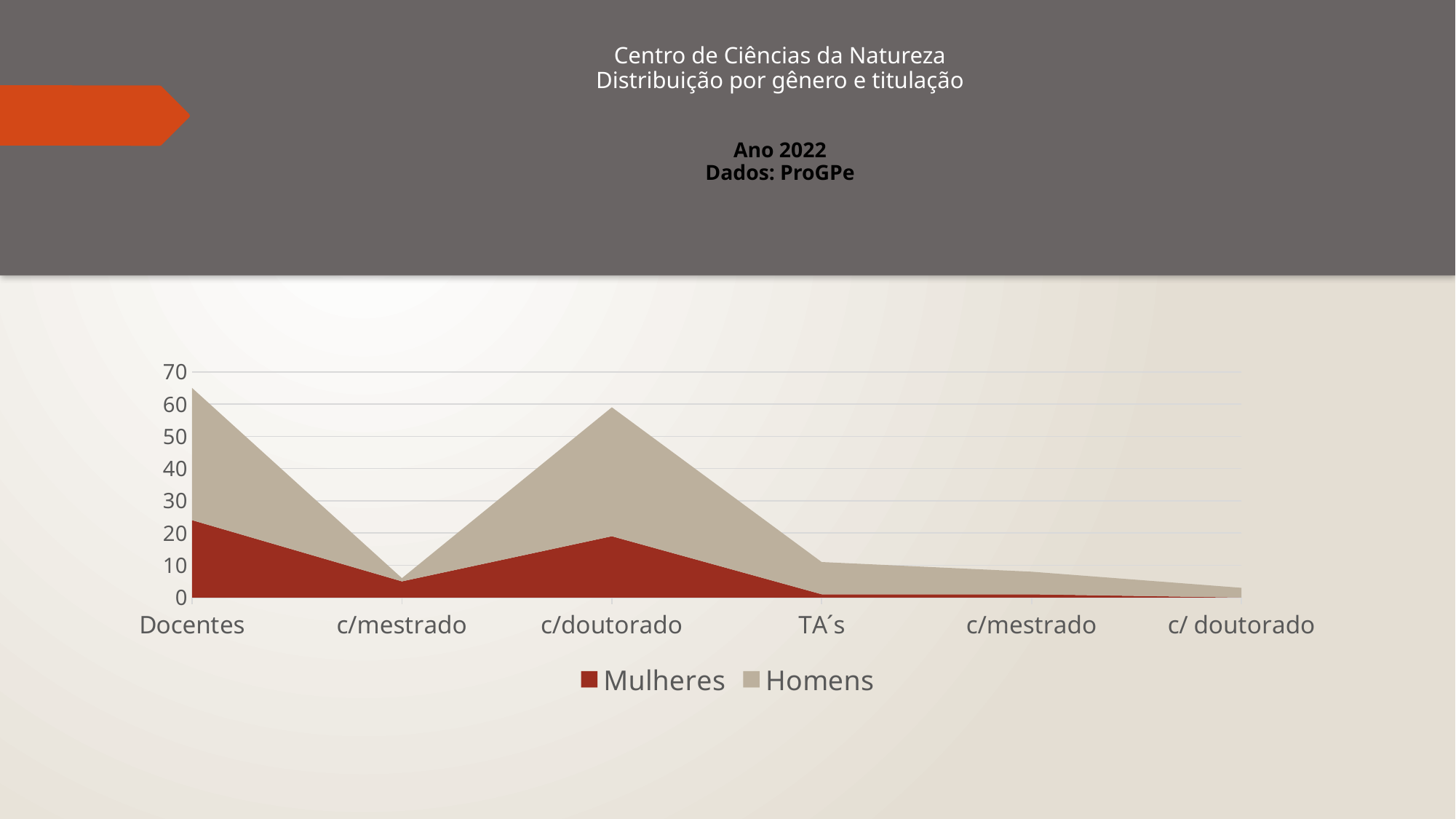
Which two series are listed in the legend? Mulheres and Homens Which has the larger stacked total, Docentes or c/doutorado (third category)? Docentes Which category has the highest value for Mulheres? Docentes Is the stacked total at c/doutorado (third category) greater or less than 50? greater How many categories are shown on the x axis? 6 Is the stacked total at TA´s greater or less than 20? less What kind of chart is shown on the slide? Area chart Is the value for Mulheres at Docentes greater or less than 20? greater How many series does the legend list? 2 Which category has the highest stacked total? Docentes What is the title of the chart? Centro de Ciências da Natureza Distribuição por gênero e titulação